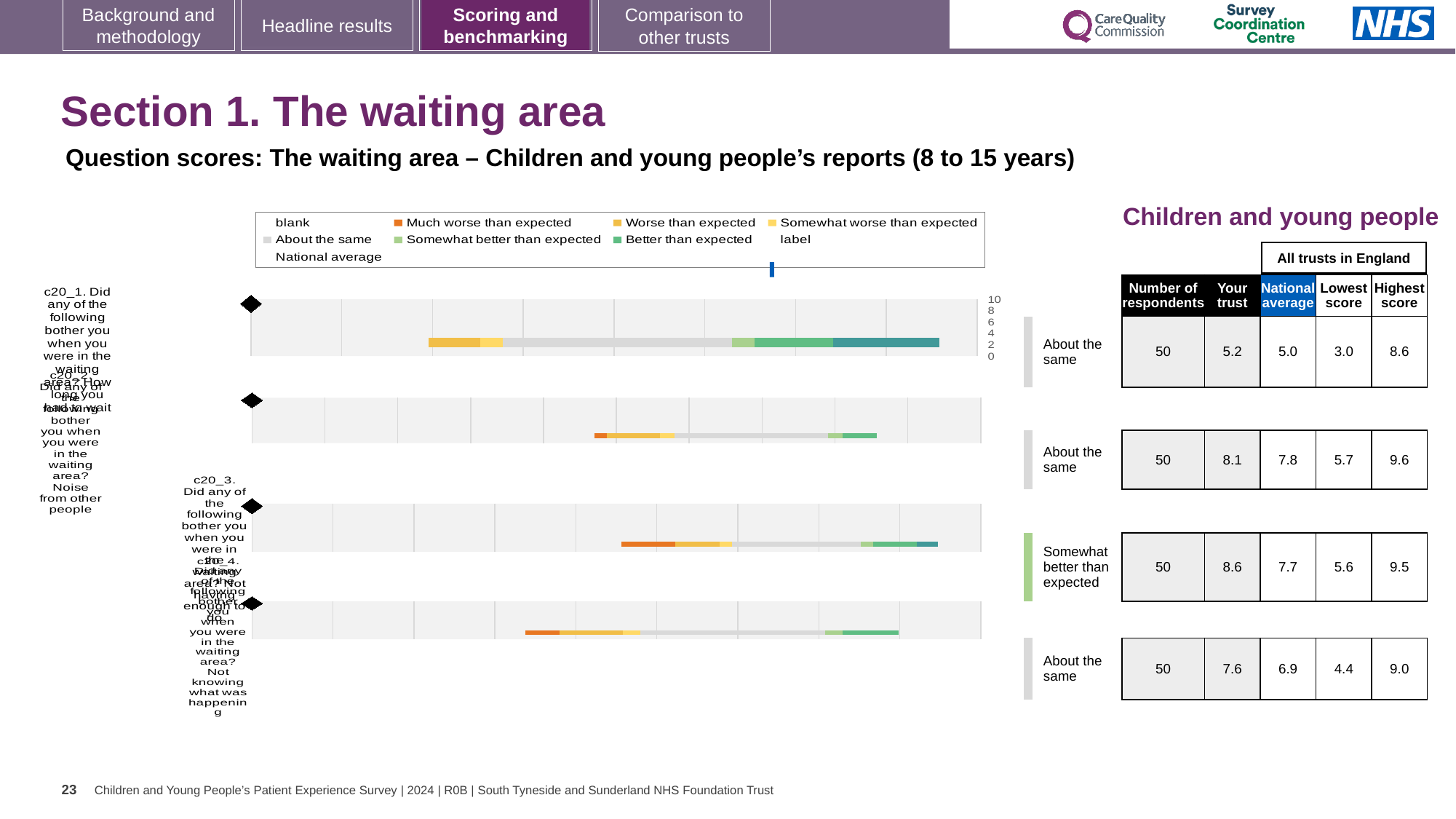
Which legend entry is shown in orange? Much worse than expected In the table beside the chart, how many respondents are listed for each row? 50 How many entries does the chart's legend list? 9 In the table beside the chart, what is the 'Your trust' score for the first row (c20_1, About the same)? 5.2 In the table beside the chart, what is the national average for the row rated 'Somewhat better than expected'? 7.7 In the table beside the chart, which row has the highest 'Your trust' score? the third row (Somewhat better than expected), 8.6 In the table beside the chart, what is the difference between the 'Your trust' score and the national average for the third row (Somewhat better than expected)? 0.9 In the table beside the chart, is the 'Your trust' score for the second row (8.1) larger or smaller than its national average (7.8)? larger What kind of chart is shown on the slide? bar chart What is the highest tick value shown on the chart's axis? 10 In the table beside the chart, which row has the lowest 'Your trust' score? the first row (c20_1), 5.2 How many horizontal bars does the chart contain? 4